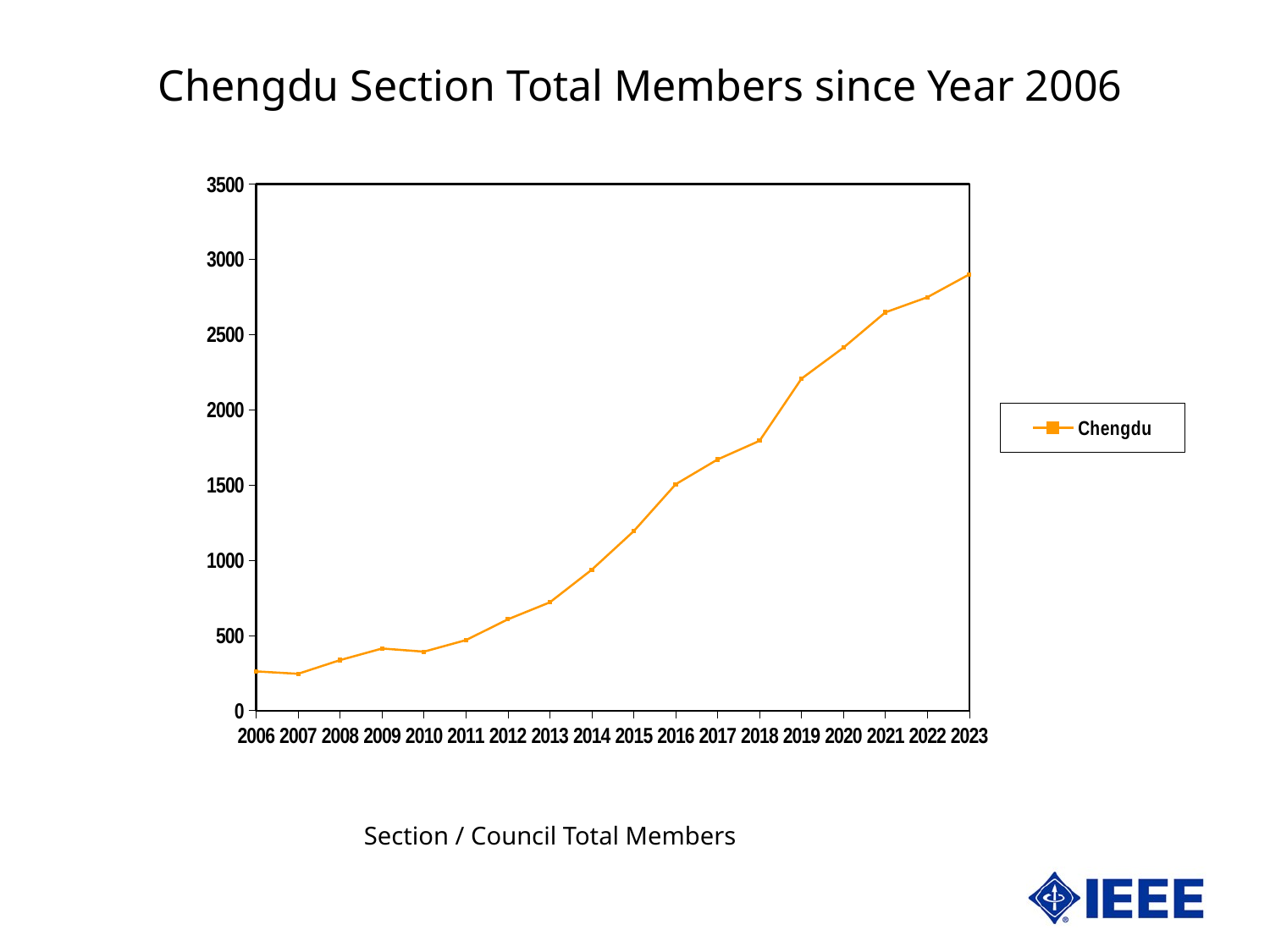
Is the value for 2006 greater or less than 500? less What is the name of the series shown in the legend? Chengdu Is the value for 2023 greater or less than 2500? greater Do the values generally rise or fall from 2006 to 2023? rise Is the value for 2018 greater or less than 2000? less Which year has the highest number of members? 2023 Which year has the larger value, 2014 or 2020? 2020 How many series does the legend list? 1 How many years are plotted along the x axis? 18 What kind of chart is shown on the slide? line chart